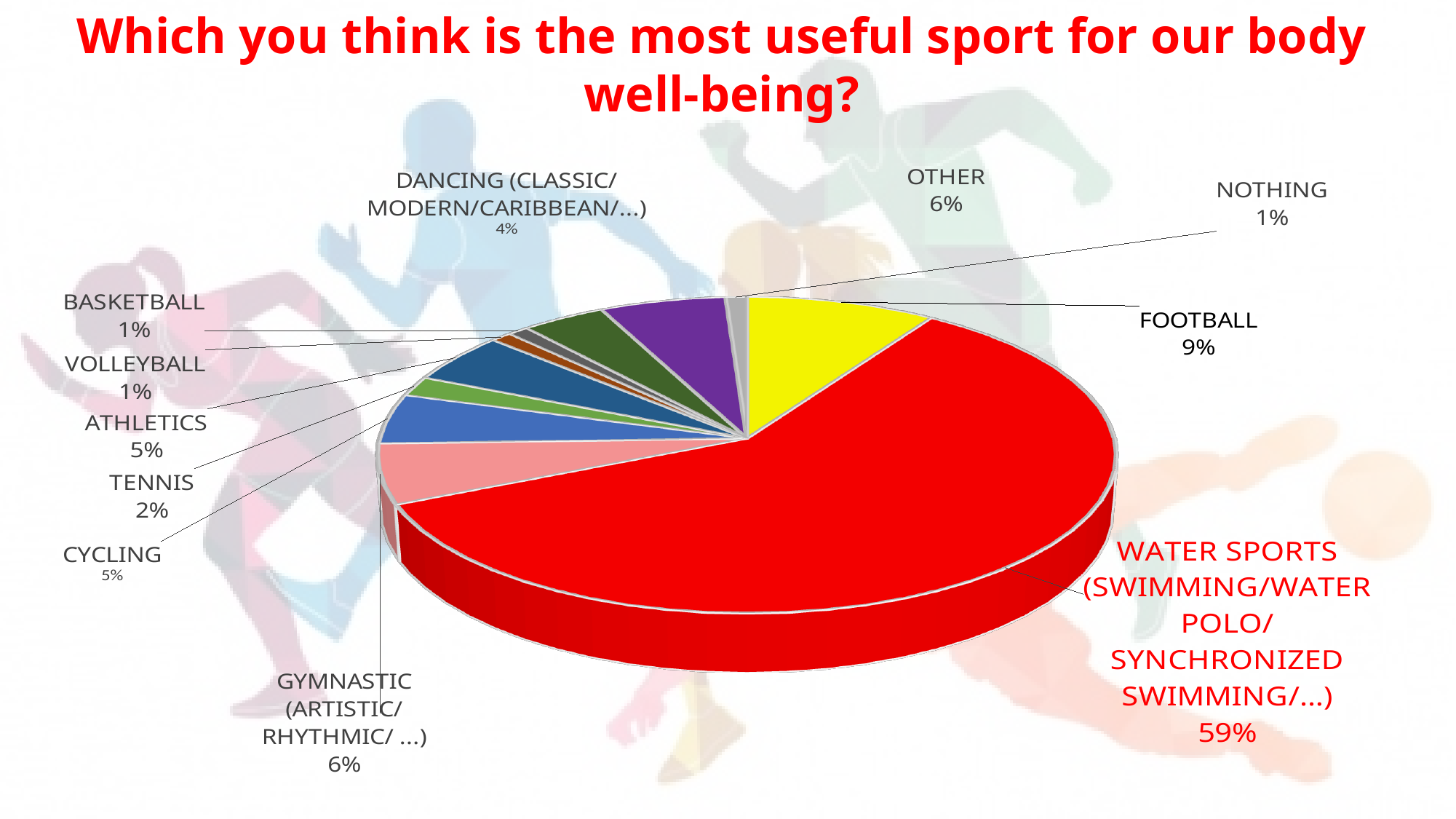
What percentage of respondents chose water sports as the most useful sport? 59% What percentage is shown for gymnastic (artistic/rhythmic/...)? 6% Which has a larger share, athletics or tennis? Athletics What percentage is shown for tennis? 2% What colour is the water sports slice? Red What is the difference in percentage points between water sports and football? 50 How many categories are shown in the pie chart? 11 What percentage is shown for dancing (classic/modern/caribbean/...)? 4% What type of chart is shown on the slide? Pie chart Which category has the largest share of the pie? Water sports (swimming/water polo/synchronized swimming/...) What share of the pie does football have? 9% What is the combined share of basketball, volleyball and nothing? 3%